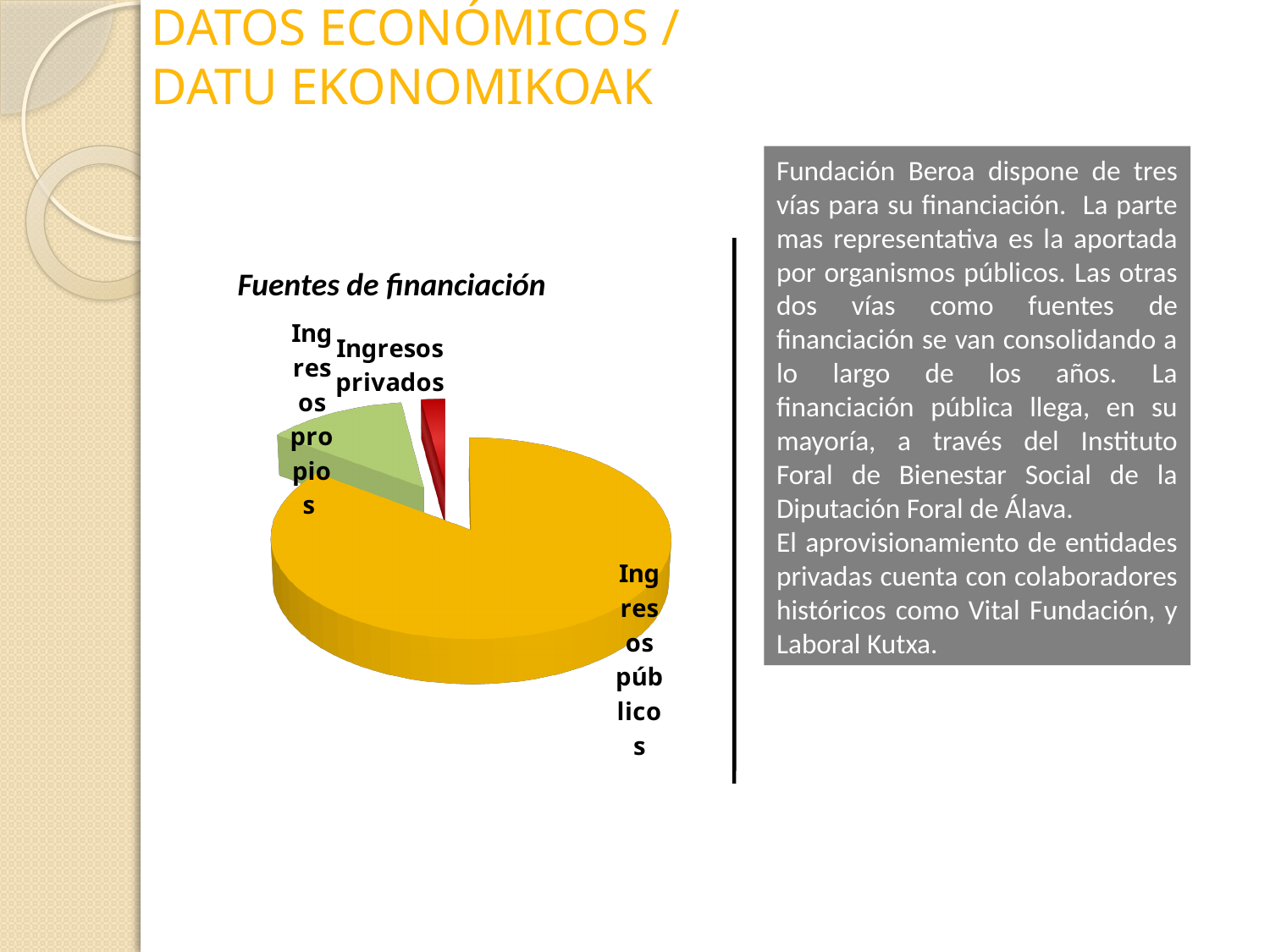
Which slice is larger, Ingresos públicos or Ingresos propios? Ingresos públicos Which slice is larger, Ingresos propios or Ingresos privados? Ingresos propios What kind of chart is shown on the slide? Pie chart Which category has the smallest slice of the pie? Ingresos privados Does the Ingresos públicos slice account for more or less than half of the pie? More What is the title of the chart? Fuentes de financiación What colour is the Ingresos públicos slice? Yellow How many slices does the pie chart have? 3 Which category has the largest slice of the pie? Ingresos públicos